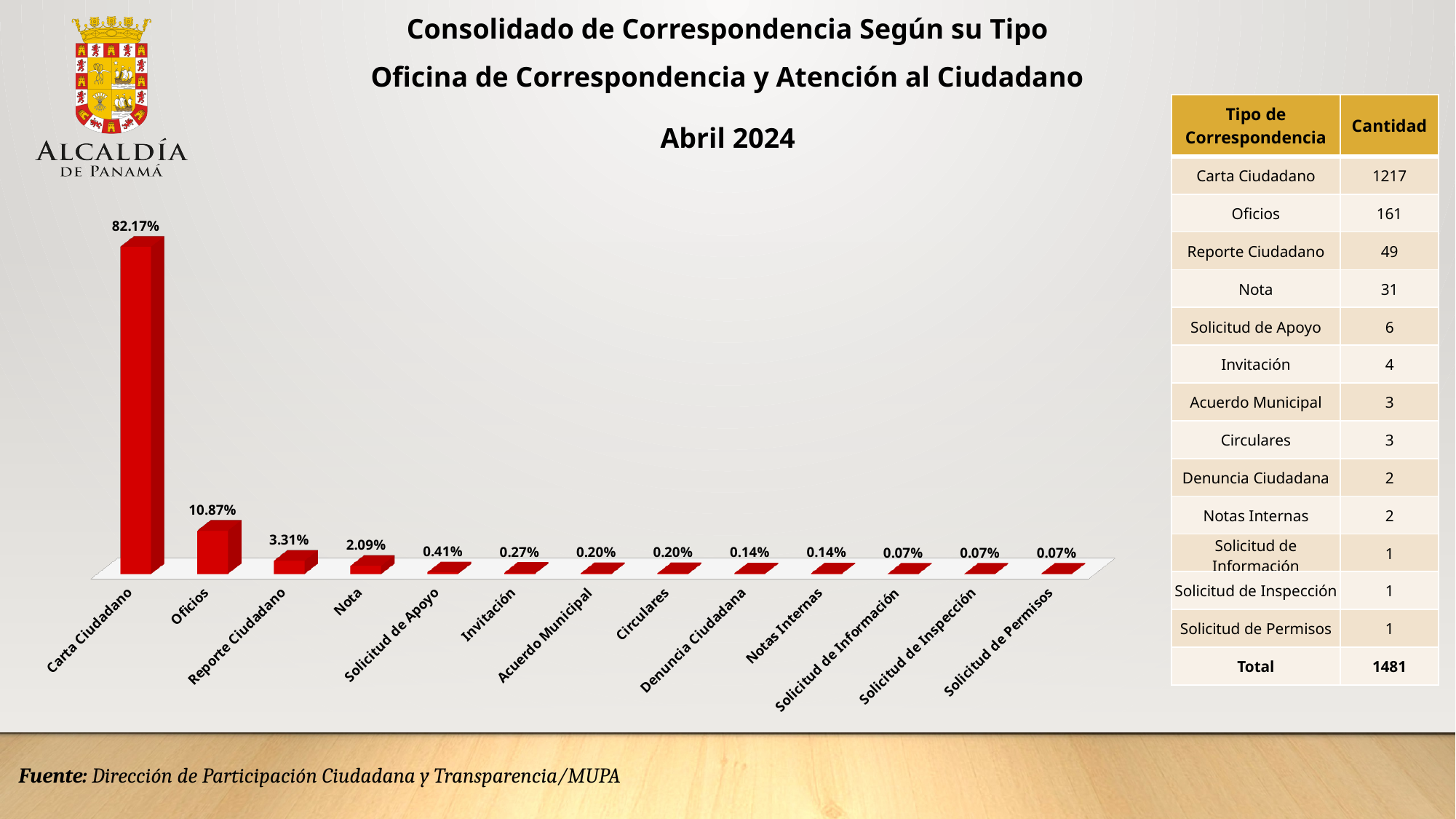
What is the value shown for Carta Ciudadano? 82.17% What is the difference between the values for Carta Ciudadano and Oficios? 71.30% What is the value shown for Nota? 2.09% What is the value shown for Solicitud de Apoyo? 0.41% What is the difference between the values for Oficios and Reporte Ciudadano? 7.56% Which has a larger value, Solicitud de Apoyo or Invitación? Solicitud de Apoyo How many categories are plotted in the chart? 13 Do the values rise or fall from left to right along the x axis? Fall What is the value shown for Oficios? 10.87% What kind of chart is shown on the slide? Bar chart Which category has the highest value in the chart? Carta Ciudadano What colour are the bars in the chart? Red